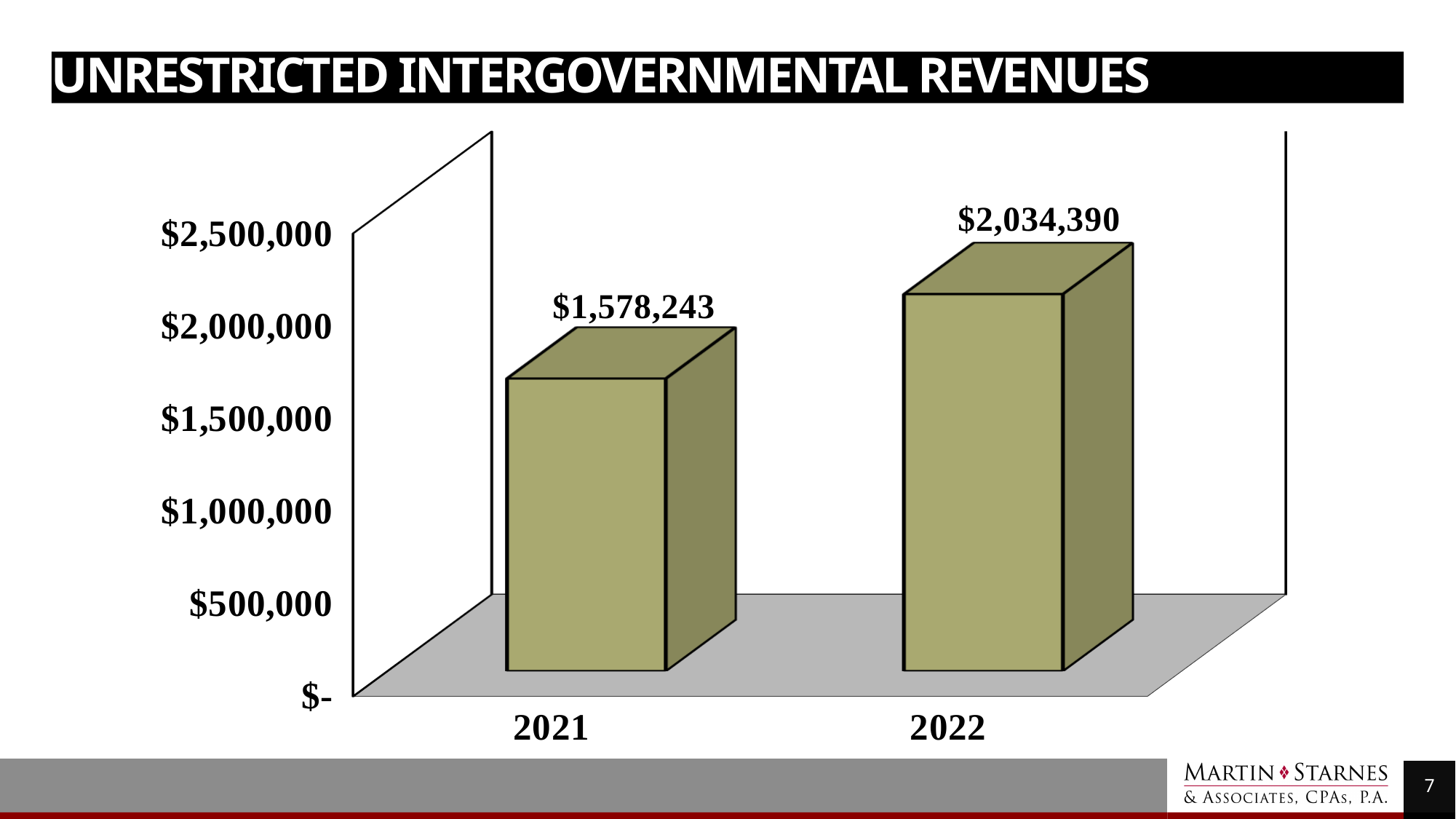
Which year has the highest unrestricted intergovernmental revenues? 2022 Do the values rise or fall from 2021 to 2022? rise What is the value for 2021? $1,578,243 Is the value for 2022 greater or less than $2,000,000? greater Is the value for 2021 greater or less than $2,000,000? less Which is larger, the value for 2021 or the value for 2022? 2022 What kind of chart is shown on the slide? bar chart What is the difference between the 2022 and 2021 values? $456,147 What is the value for 2022? $2,034,390 What is the title of the chart? Unrestricted Intergovernmental Revenues How many years are shown on the chart? 2 Which year has the lowest unrestricted intergovernmental revenues? 2021